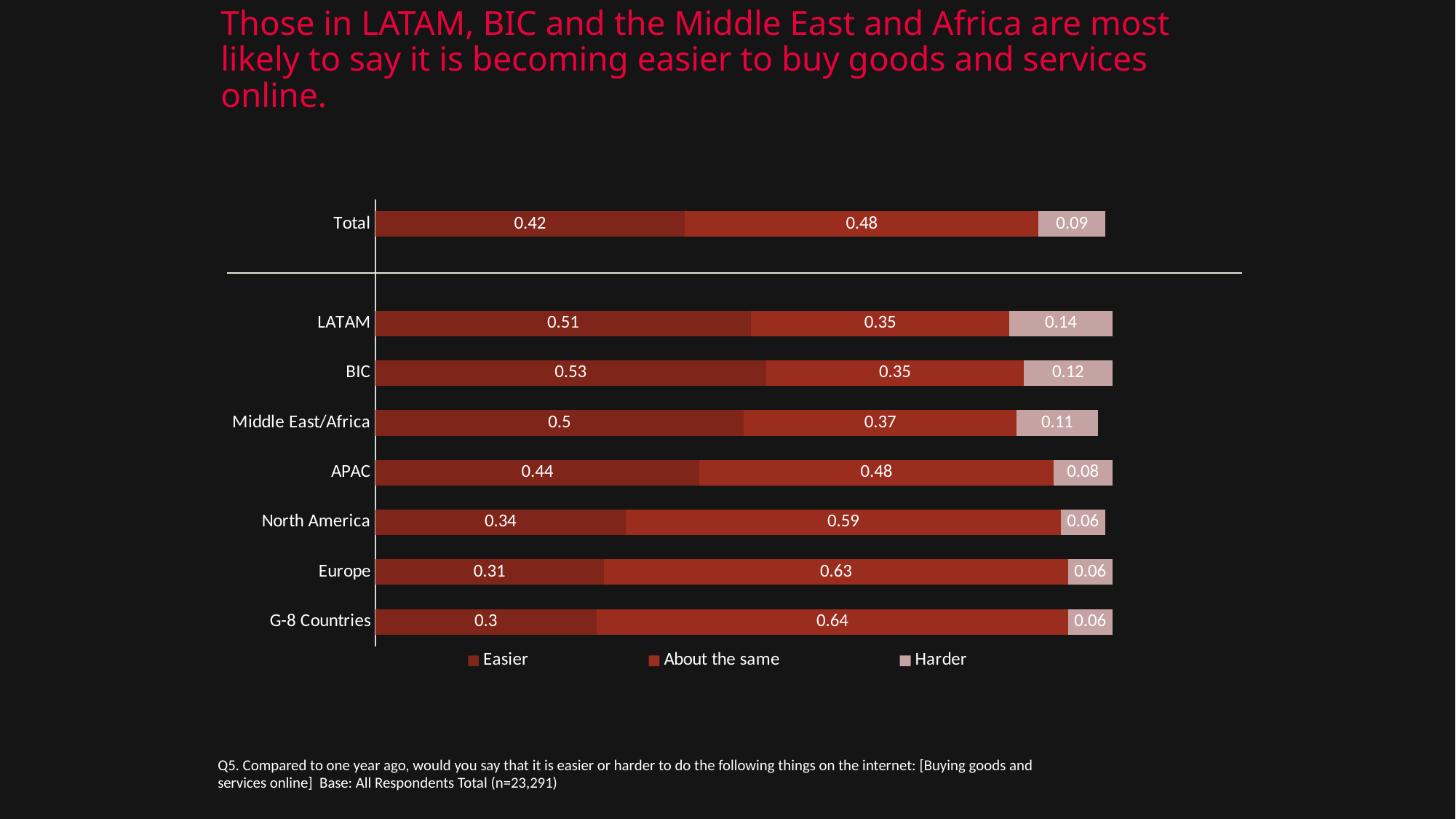
What is the total of the stacked bar for Europe? 1 Which region has the highest 'Easier' value? BIC What is the 'Harder' value for Total? 0.09 Which category has the highest 'Harder' value? LATAM Which category has the lowest 'Easier' value? G-8 Countries How many series does the legend list? 3 How many categories (bars) are shown in the chart? 8 What is the difference between the 'About the same' values for G-8 Countries and LATAM? 0.29 What kind of chart is shown on the slide? Stacked bar chart What is the 'Easier' value for LATAM? 0.51 Which is larger, the 'Easier' value for APAC or for Middle East/Africa? Middle East/Africa What is the 'About the same' value for North America? 0.59